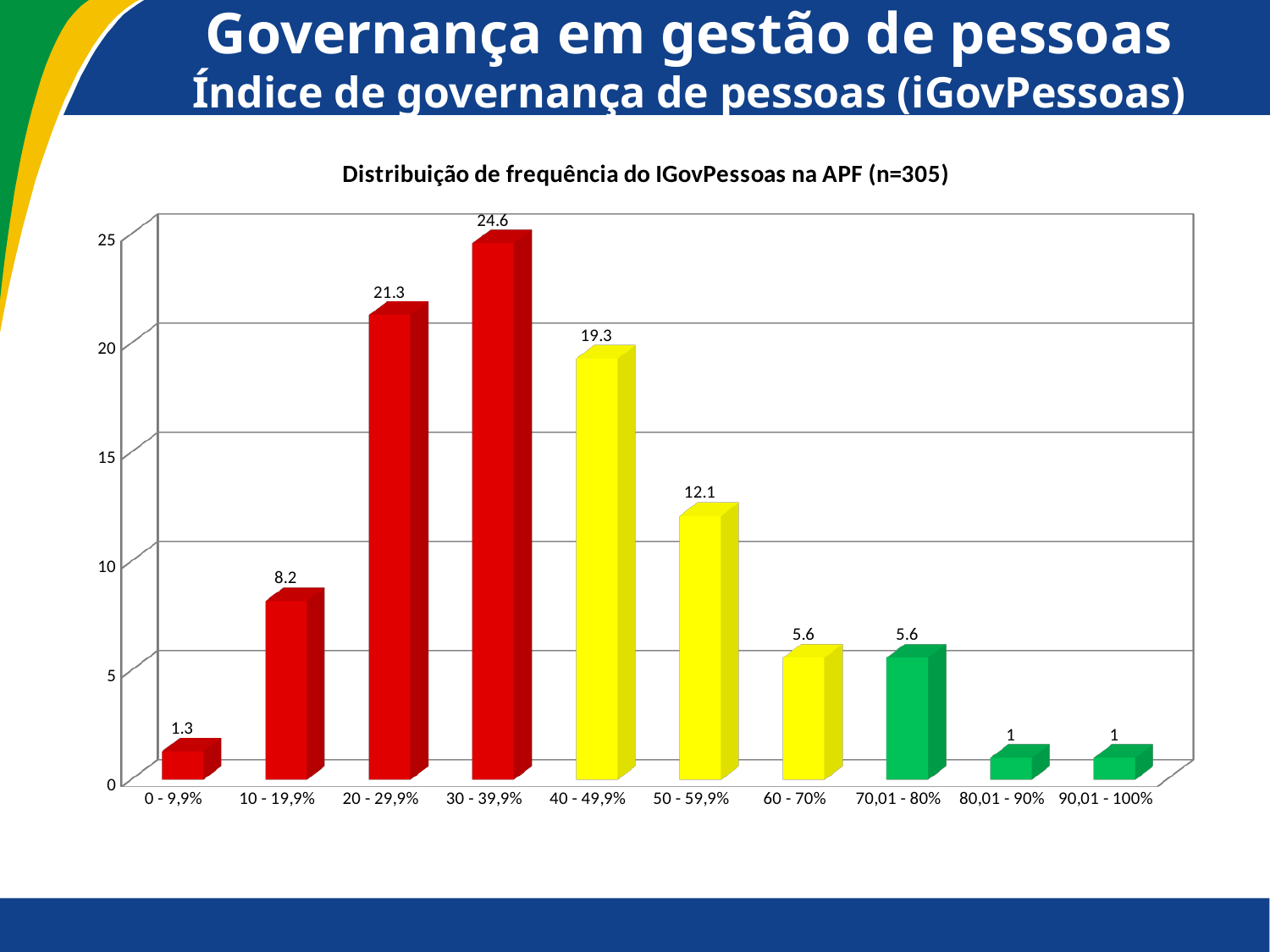
Which is larger, the value for 10 - 19,9% or the value for 60 - 70%? 10 - 19,9% What kind of chart is shown on the slide? bar chart Do the values rise or fall from the 30 - 39,9% category to the 90,01 - 100% category? fall What is the value for the 10 - 19,9% category? 8.2 What is the title of the chart? Distribuição de frequência do IGovPessoas na APF (n=305) Is the value for 40 - 49,9% greater or less than 15? greater What is the difference between the values for 40 - 49,9% and 50 - 59,9%? 7.2 What is the difference between the values for 30 - 39,9% and 20 - 29,9%? 3.3 What is the value for the 50 - 59,9% category? 12.1 How many categories are shown on the x axis? 10 Which category has the highest value? 30 - 39,9% What is the value for the 30 - 39,9% category? 24.6